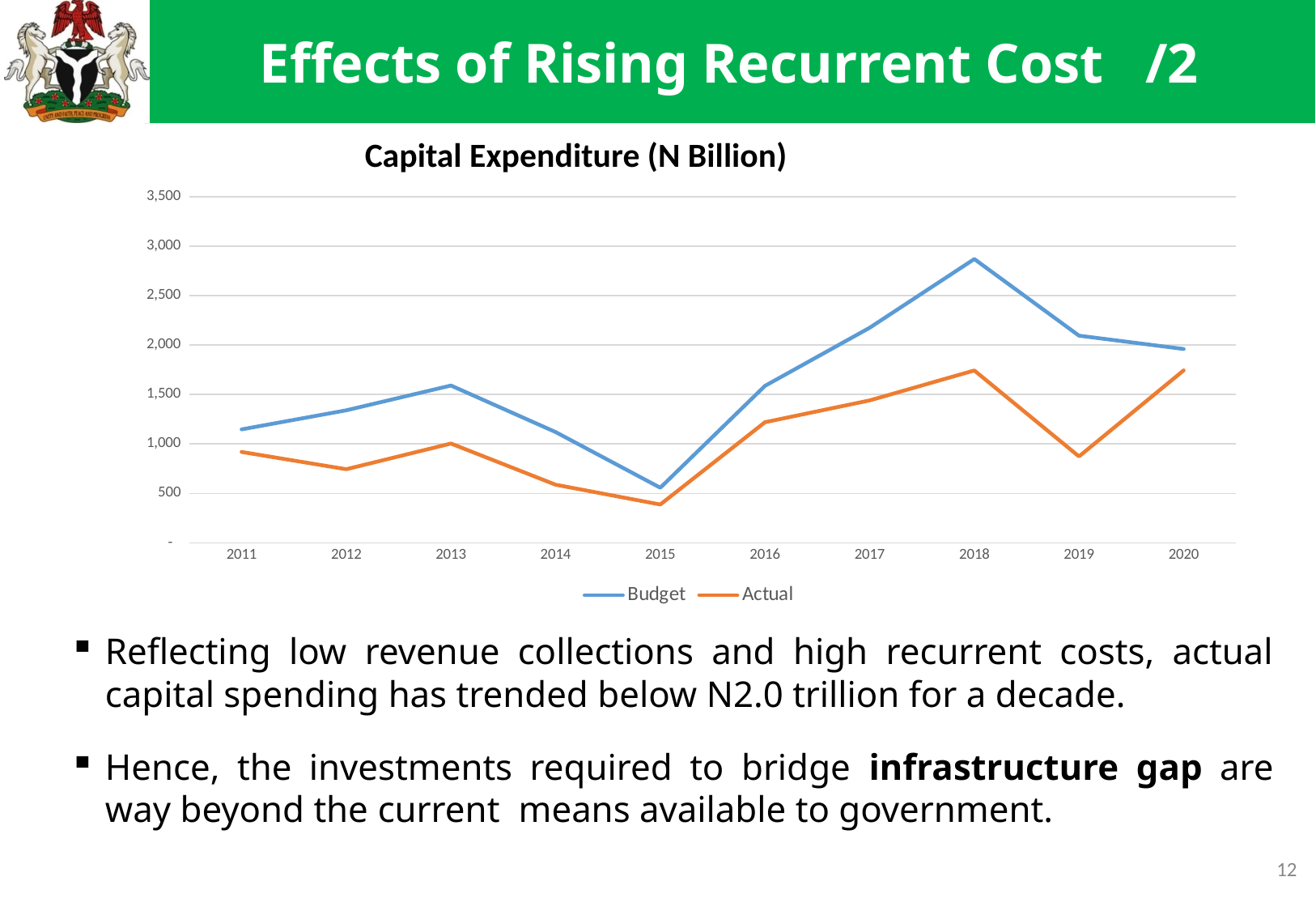
Is the Budget value for 2018 greater or less than 2,500? greater Is the Actual value for 2019 greater or less than 1,000? less Does the Budget line rise or fall from 2018 to 2020? fall In which year is the Budget value lowest? 2015 What kind of chart is shown on the slide? line chart How many series does the legend list? 2 What is the title of the chart? Capital Expenditure (N Billion) Is the Actual value for 2015 greater or less than 500? less In which year is the Actual value lowest? 2015 How many years are plotted along the x axis? 10 In 2018, which series has the larger value, Budget or Actual? Budget In which year is the Budget value highest? 2018